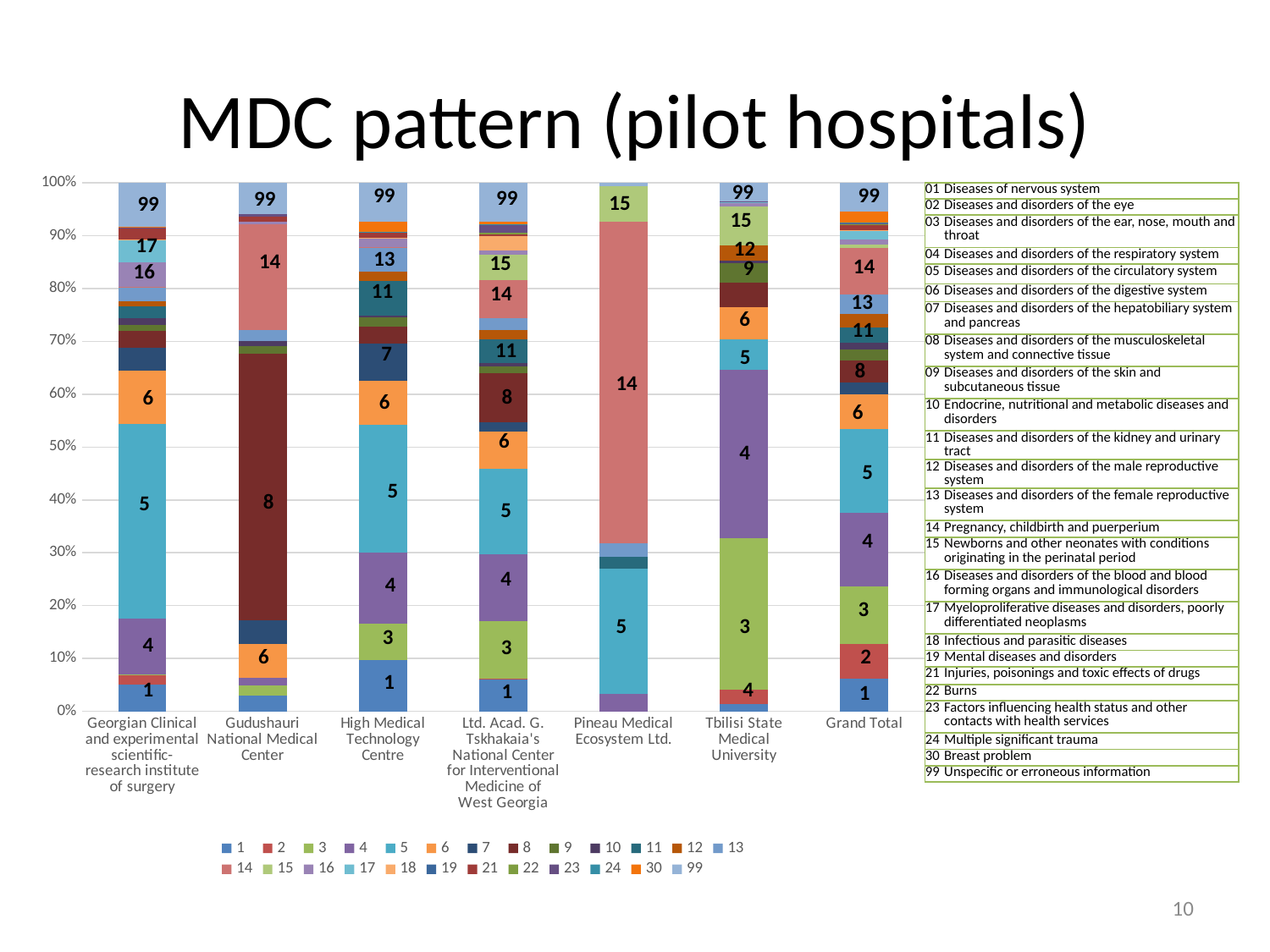
What is the title of the chart? MDC pattern (pilot hospitals) How many bars (hospital categories including Grand Total) are plotted on the x axis? 7 What kind of chart is shown on the slide? Stacked bar chart In the Georgian Clinical and experimental scientific-research institute of surgery bar, is the share of MDC 5 greater or less than 30%? greater Which hospital's bar has the largest segment for MDC 8? Gudushauri National Medical Center Which hospital's bar has the largest segment for MDC 3? Tbilisi State Medical University Which is larger in the Tbilisi State Medical University bar: the MDC 4 segment or the MDC 5 segment? MDC 4 In the Gudushauri National Medical Center bar, is the share of MDC 8 greater or less than 40%? greater In the Grand Total bar, is the share of MDC 1 greater or less than 10%? less Which hospital's bar has the largest segment for MDC 14? Pineau Medical Ecosystem Ltd. How many series does the legend list? 25